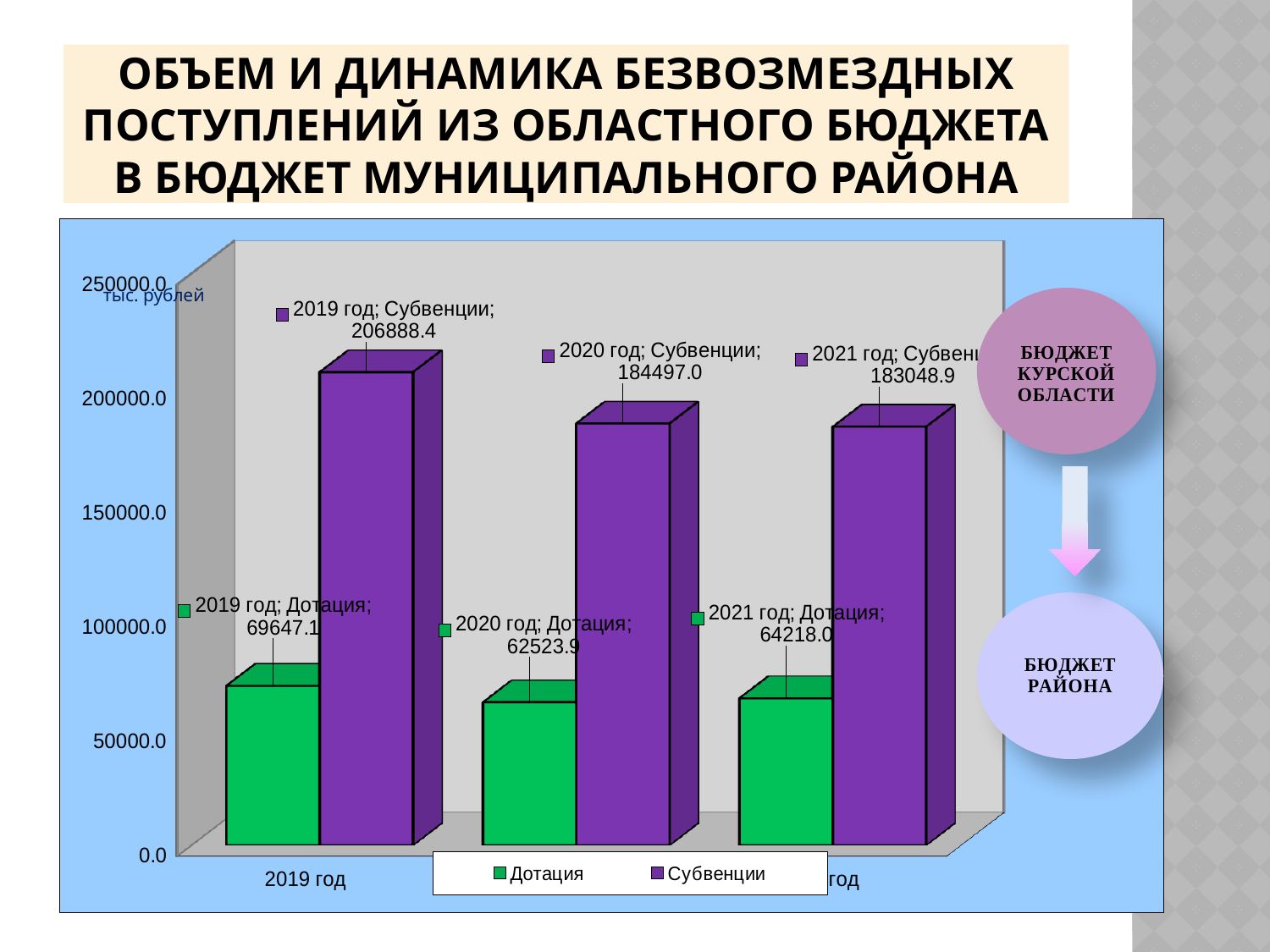
What is the value for Дотация in 2021 год? 64218.0 In which year is the Дотация value lowest? 2020 год In which year is the Субвенции value highest? 2019 год What is the value for Дотация in 2020 год? 62523.9 Which series is shown in purple in the legend? Субвенции What kind of chart is shown on the slide? bar chart What is the value for Субвенции in 2021 год? 183048.9 What is the value for Субвенции in 2019 год? 206888.4 Which is larger: Дотация in 2019 год or Дотация in 2021 год? Дотация in 2019 год What is the difference between the Субвенции values for 2019 год and 2020 год? 22391.4 How many series does the legend list? 2 Is the value for Субвенции in 2020 год greater or less than 200000.0? less